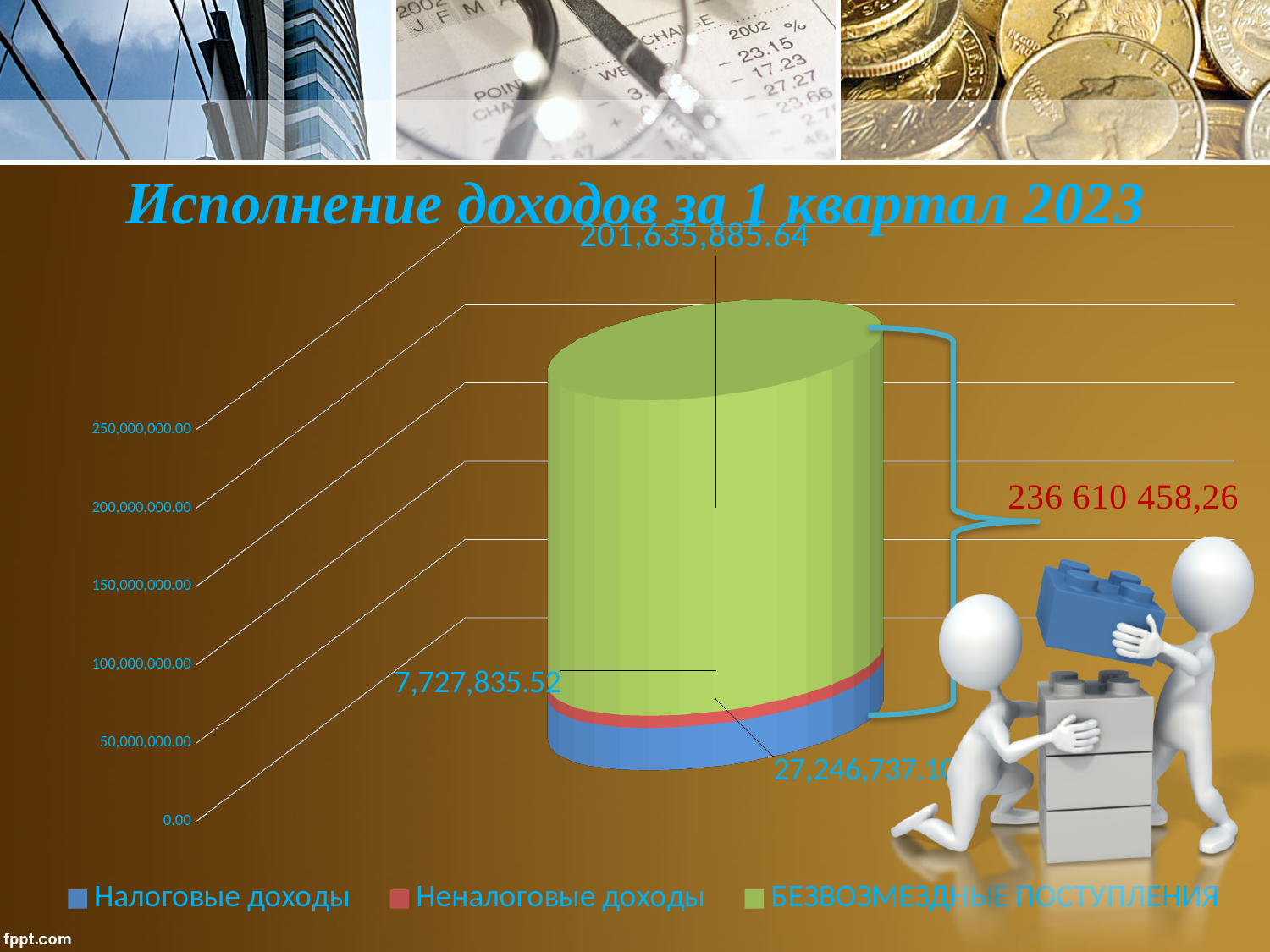
How many series does the legend list? 3 Which series has the smallest value? Неналоговые доходы What is the value shown for Неналоговые доходы? 7,727,835.52 Is the value for Налоговые доходы greater or less than 50,000,000.00? less What is the value shown for БЕЗВОЗМЕЗДНЫЕ ПОСТУПЛЕНИЯ? 201,635,885.64 What kind of chart is shown on the slide? Stacked bar chart Which is larger, Налоговые доходы or Неналоговые доходы? Налоговые доходы Which series has the largest value? БЕЗВОЗМЕЗДНЫЕ ПОСТУПЛЕНИЯ What is the difference between the values for БЕЗВОЗМЕЗДНЫЕ ПОСТУПЛЕНИЯ and Неналоговые доходы? 193,908,050.12 What colour represents Налоговые доходы in the chart? Blue What is the total of the stacked bar? 236 610 458,26 What is the title of the chart? Исполнение доходов за 1 квартал 2023